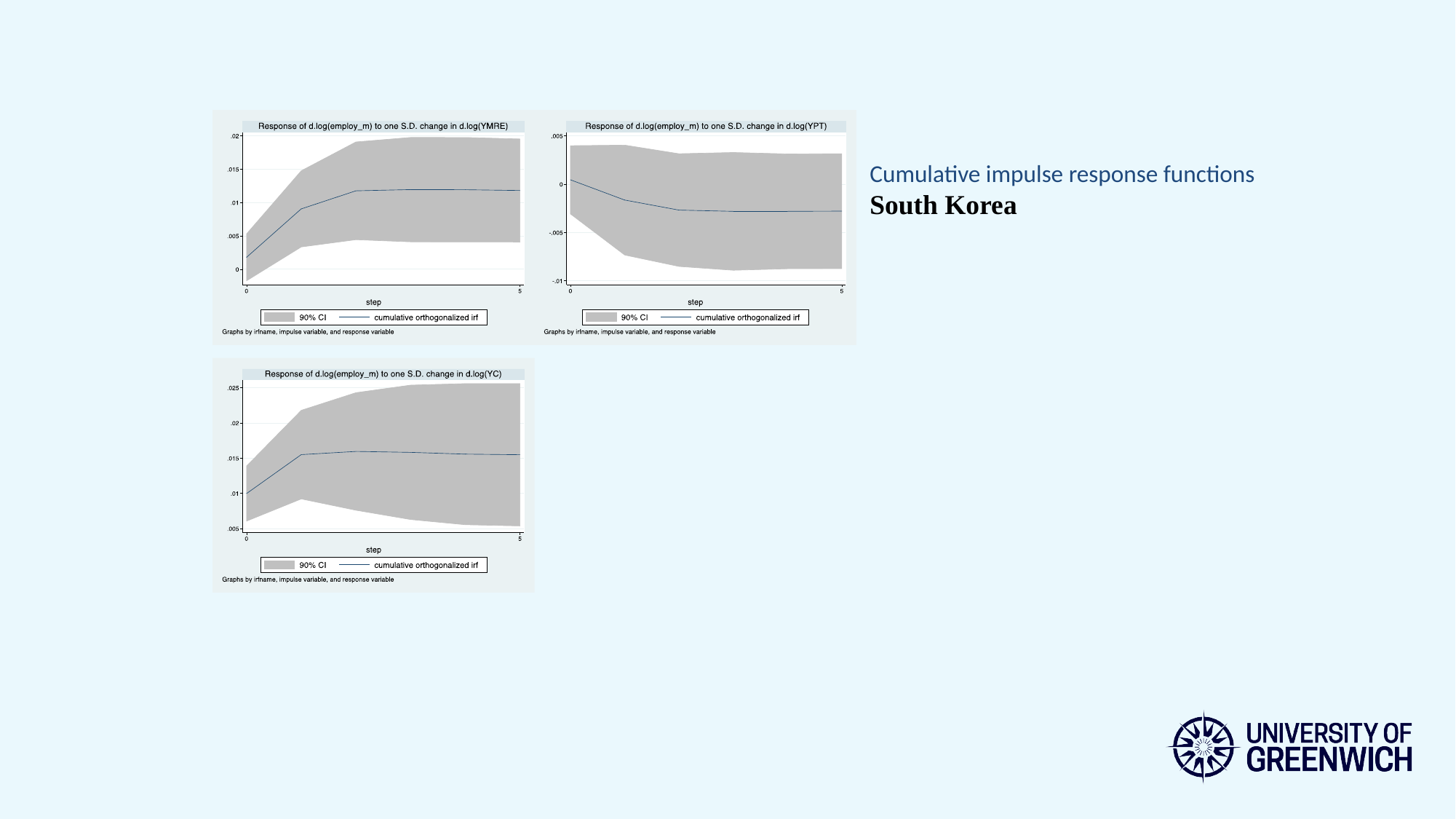
In the 'Response of d.log(employ_m) to one S.D. change in d.log(YPT)' chart, is the cumulative orthogonalized irf at step 5 greater or less than -.005? greater In the 'Response of d.log(employ_m) to one S.D. change in d.log(YPT)' chart, is the cumulative orthogonalized irf at step 5 greater or less than 0? less What confidence interval does the shaded band represent in the 'Response of d.log(employ_m) to one S.D. change in d.log(YC)' chart, according to the legend? 90% CI What kind of chart is the 'Response of d.log(employ_m) to one S.D. change in d.log(YMRE)' chart? line chart In the 'Response of d.log(employ_m) to one S.D. change in d.log(YMRE)' chart, how many entries does the legend list? 2 How many charts are shown on the slide? 3 In the 'Response of d.log(employ_m) to one S.D. change in d.log(YMRE)' chart, does the cumulative orthogonalized irf rise or fall from step 0 to step 5? rise In the 'Response of d.log(employ_m) to one S.D. change in d.log(YPT)' chart, does the cumulative orthogonalized irf rise or fall from step 0 to step 5? fall In the 'Response of d.log(employ_m) to one S.D. change in d.log(YC)' chart, is the cumulative orthogonalized irf at step 5 greater or less than .01? greater What is the x-axis label on the 'Response of d.log(employ_m) to one S.D. change in d.log(YC)' chart? step